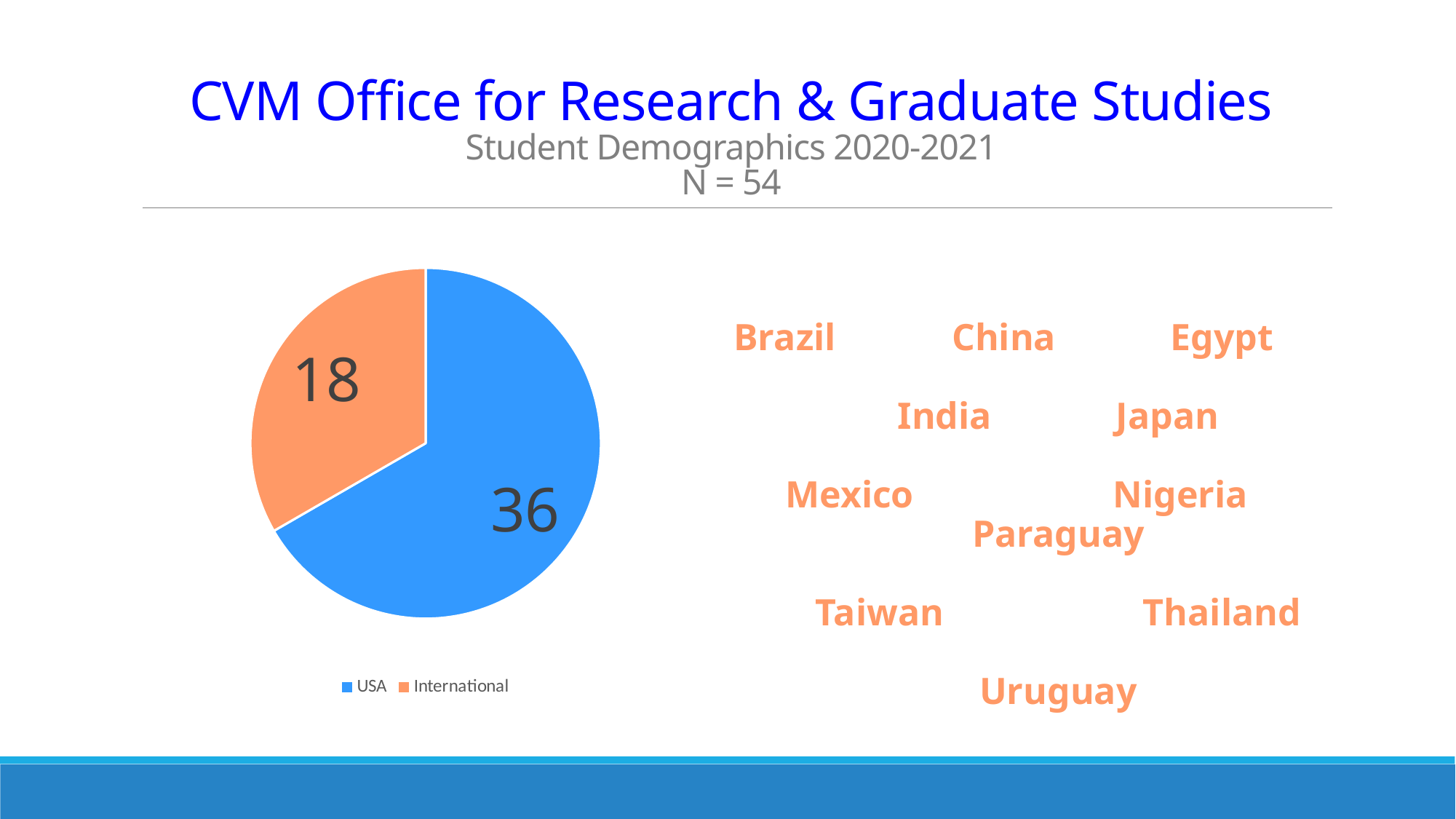
How many entries does the pie chart legend list? 2 What share of the pie chart does the International slice represent? One third Which is larger in the pie chart, USA or International? USA Which category has the largest slice in the pie chart? USA What is the value for USA in the pie chart? 36 Which category has the smallest slice in the pie chart? International How many categories does the pie chart show? 2 What is the value for International in the pie chart? 18 What kind of chart is shown on the slide? Pie chart What is the total of the two slices in the pie chart? 54 What is the difference between the USA and International values in the pie chart? 18 What colour is the USA slice in the pie chart? Blue